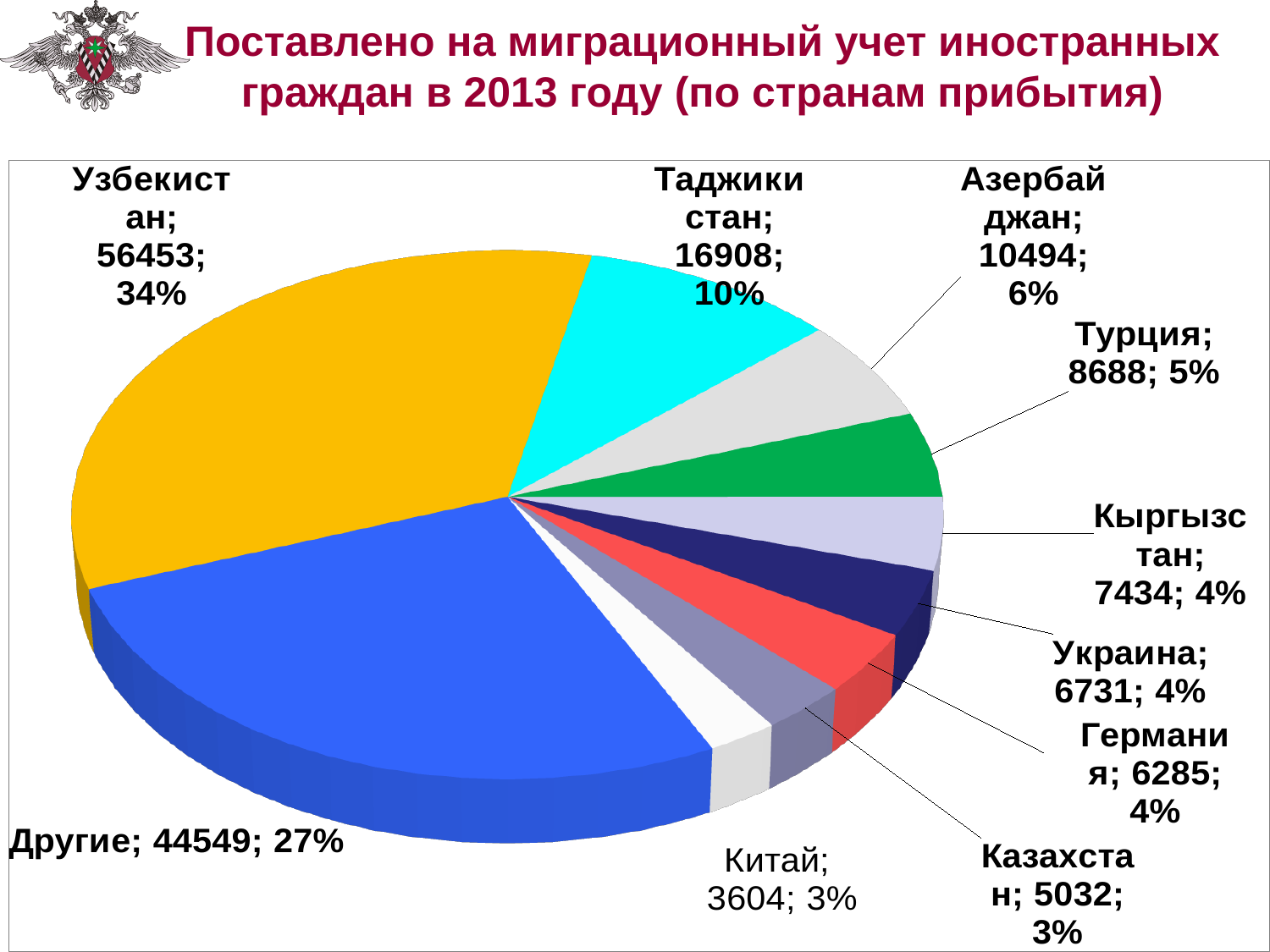
Which is larger, the value for Турция or the value for Кыргызстан? Турция What is the title of the chart? Поставлено на миграционный учет иностранных граждан в 2013 году (по странам прибытия) What share of the pie does Другие have? 27% Which country has the largest slice of the pie? Узбекистан What share of the pie does Таджикистан have? 10% What value is shown for Узбекистан? 56453 What value is shown for Казахстан? 5032 How many slices does the pie chart have? 10 What is the difference between the values for Узбекистан and Другие? 11904 What value is shown for Азербайджан? 10494 What kind of chart is shown on the slide? pie chart Which category has the smallest slice of the pie? Китай